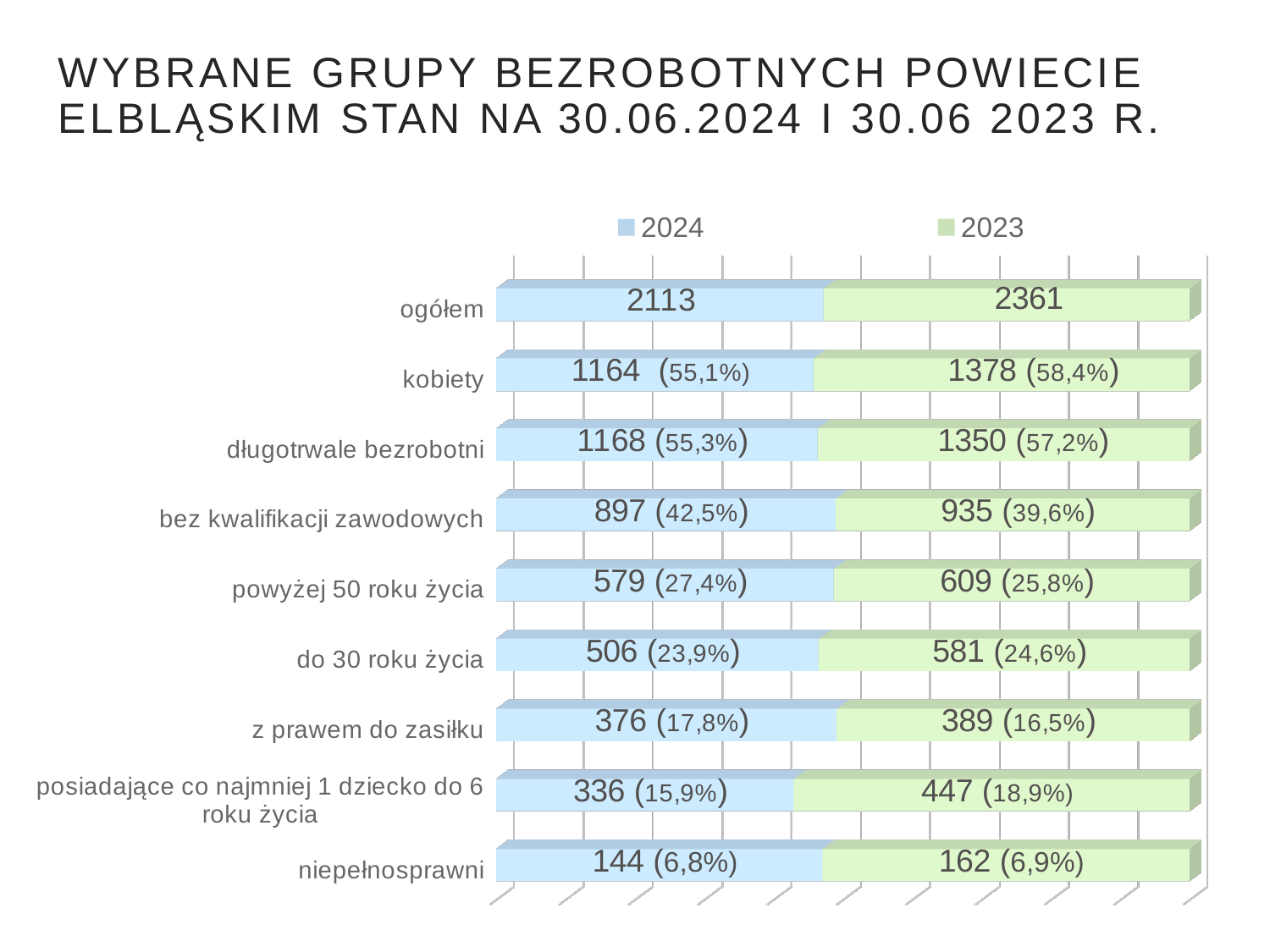
What is the difference between the 2023 and 2024 values for "ogółem"? 248 What percentage is shown next to the 2023 value for "długotrwale bezrobotni"? 57,2% What is the 2023 value for "kobiety"? 1378 What kind of chart is shown on the slide? bar chart How many series does the legend list? 2 What is the difference between the 2023 and 2024 values for "posiadające co najmniej 1 dziecko do 6 roku życia"? 111 Which category has the lowest 2024 value? niepełnosprawni What is the 2024 value for "ogółem"? 2113 How many categories are shown on the chart? 9 What is the 2024 value for "niepełnosprawni"? 144 Which is larger for "do 30 roku życia": the 2024 value or the 2023 value? 2023 Which category has the highest 2023 value? ogółem